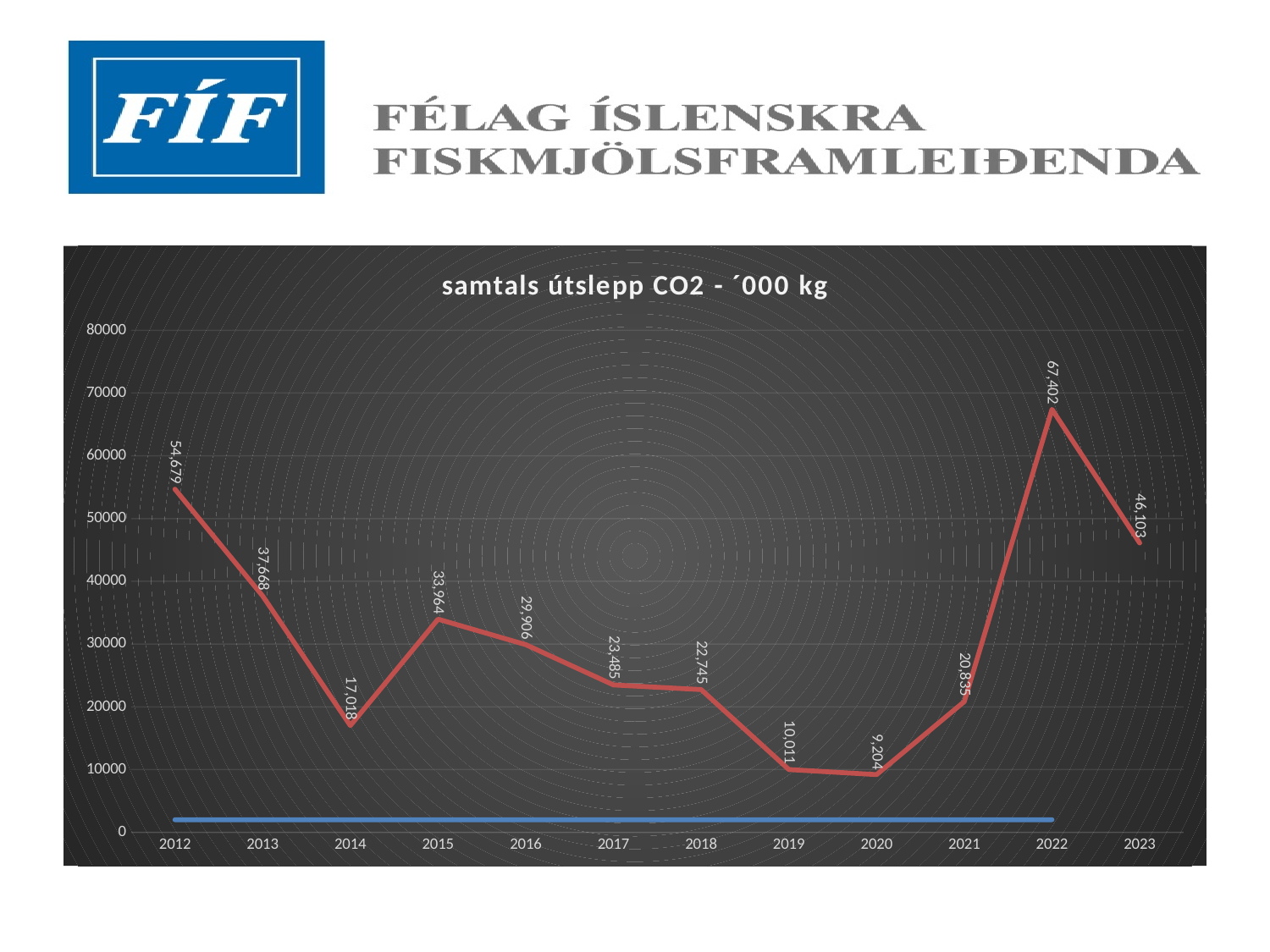
What is the value for 2020? 9,204 What is the difference between the values for 2022 and 2023? 21,299 Which year has the lowest value on the red line? 2020 What kind of chart is this? line chart What is the title of the chart? samtals útslepp CO2 - ´000 kg How many years are shown on the x axis? 12 What is the value for 2022? 67,402 Which year has the highest value on the red line? 2022 Which is larger, the value for 2015 or the value for 2017? 2015 What is the difference between the values for 2012 and 2013? 17,011 What is the value for 2016? 29,906 What is the value for 2012? 54,679